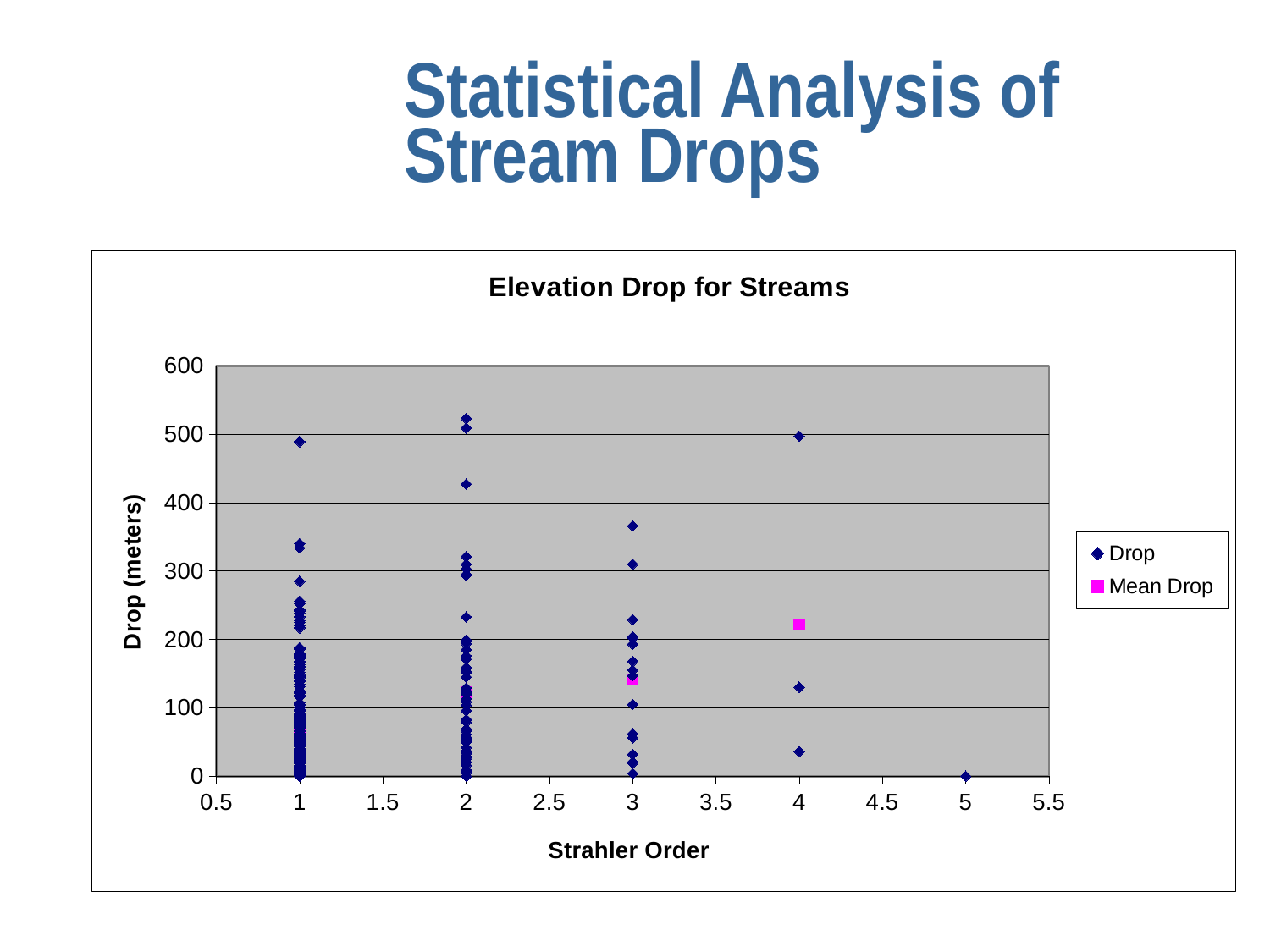
Is the Mean Drop value at Strahler Order 3 greater or less than 200? less What is the label of the y axis? Drop (meters) Is the highest Drop point at Strahler Order 2 greater or less than 500? greater What is the title of the chart? Elevation Drop for Streams How many series does the legend list? 2 Which is larger, the Mean Drop at Strahler Order 3 or at Strahler Order 4? Strahler Order 4 Is the Mean Drop value at Strahler Order 4 greater or less than 200? greater How many distinct Strahler Order values have Drop points plotted? 5 What kind of chart is shown on the slide? scatter chart